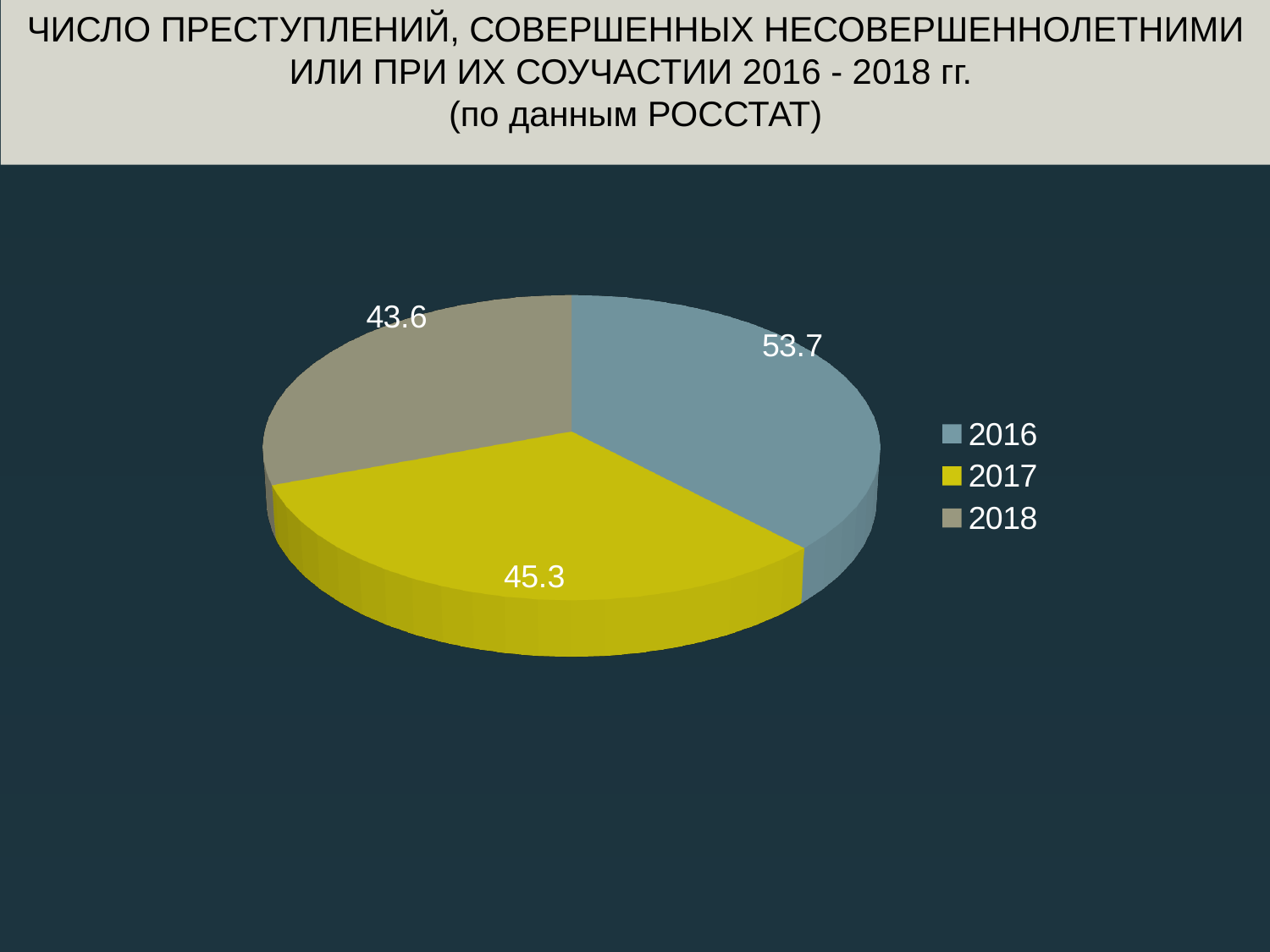
What value is shown for 2017 on the pie chart? 45.3 What value is shown for 2018 on the pie chart? 43.6 What value is shown for 2016 on the pie chart? 53.7 How many slices does the pie chart have? 3 What kind of chart is shown on the slide? Pie chart What is the difference between the values for 2016 and 2017? 8.4 How many entries does the legend list? 3 Which is larger, the value for 2017 or the value for 2018? 2017 Which year has the largest slice of the pie chart? 2016 Do the values decrease or increase from 2016 to 2018? Decrease Which year has the smallest slice of the pie chart? 2018 What is the difference between the values for 2016 and 2018? 14.1